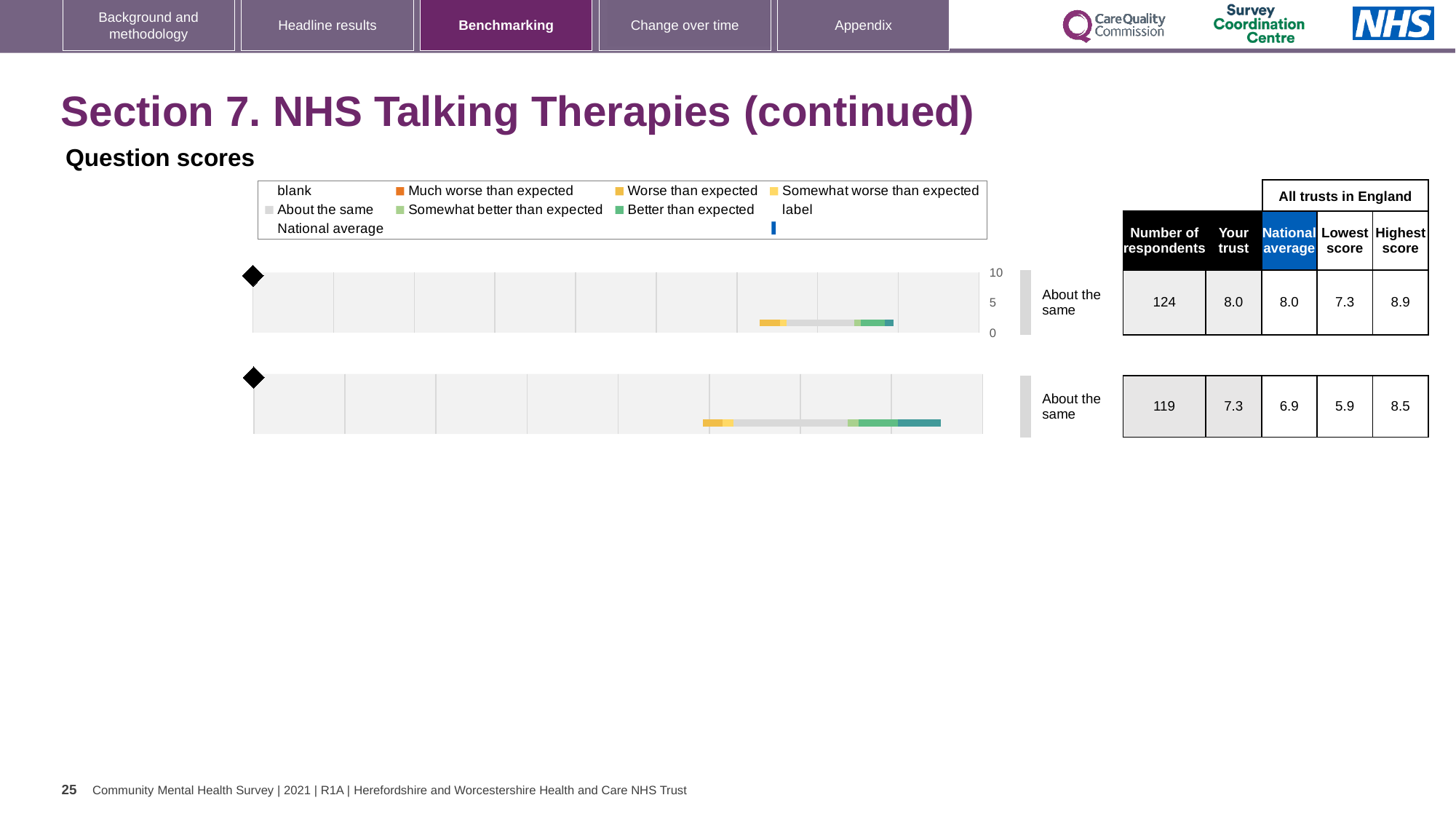
In the legend, what colour represents 'Much worse than expected'? Orange For the top chart, what is the number of respondents shown in the table? 124 What benchmark category label is shown next to the bottom chart? About the same For the bottom chart, what is the lowest score among all trusts in England? 5.9 For the bottom chart, which is larger: the 'Your trust' score or the national average? Your trust For the bottom chart, what is the national average score? 6.9 How many question score charts are shown on the slide? 2 For the top chart, what is the difference between the highest score and the lowest score among all trusts in England? 1.6 For the bottom chart, what is the difference between the highest score and the lowest score among all trusts in England? 2.6 What is the highest value shown on the axis of the top chart? 10 What kind of chart is used to show the question scores on this slide? Bar chart For the top chart, what is the 'Your trust' score? 8.0